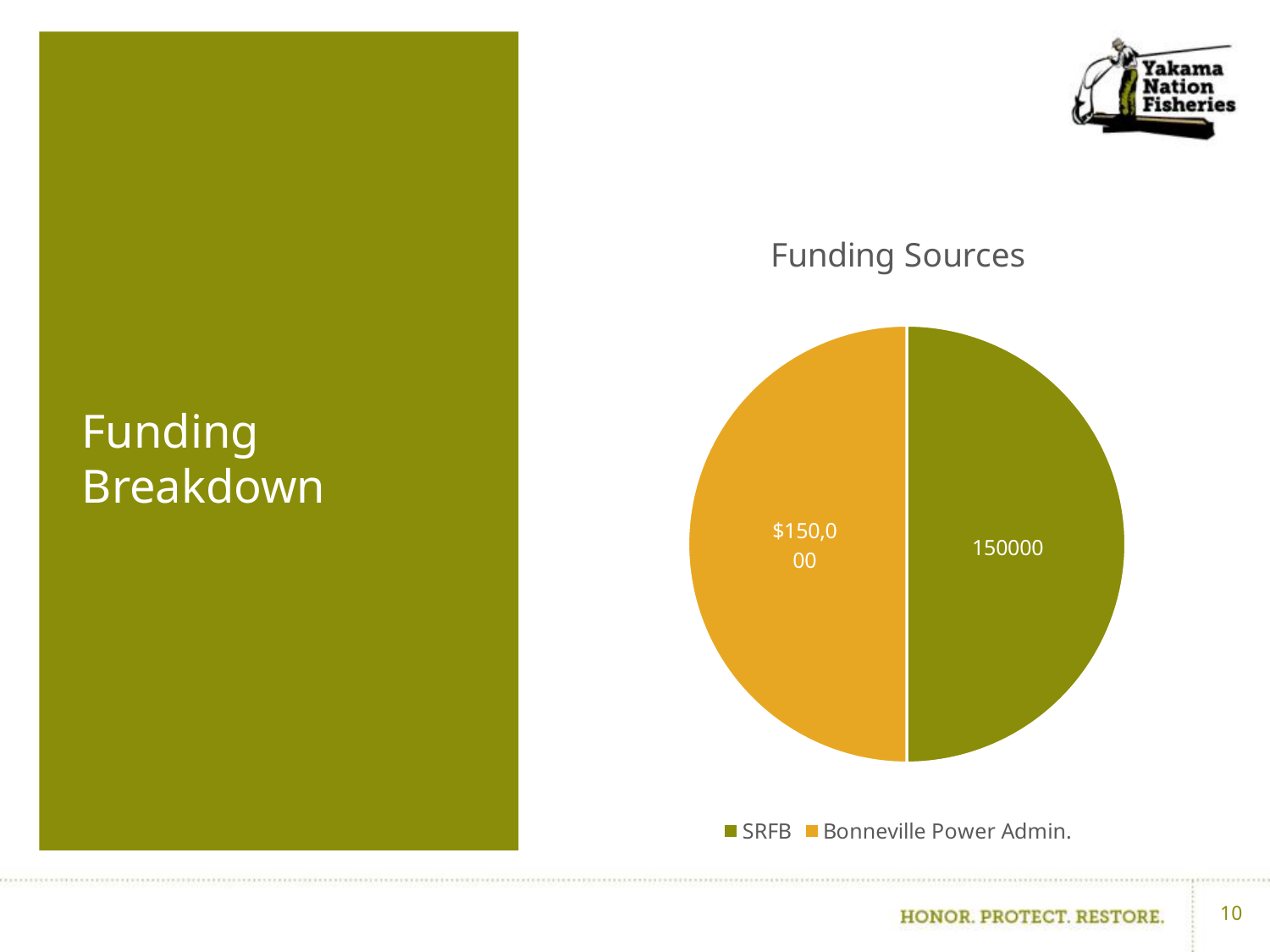
How many entries does the legend list? 2 Is the value for SRFB greater or less than 100000? greater Which colour is used for the SRFB slice? green What value is shown on the SRFB slice? 150000 What share of the pie does the SRFB slice represent? 50% What value is shown on the Bonneville Power Admin. slice? $150,000 What kind of chart is shown on the slide? pie chart How many slices does the pie chart have? 2 What is the title of the chart? Funding Sources What share of the pie does the Bonneville Power Admin. slice represent? 50%